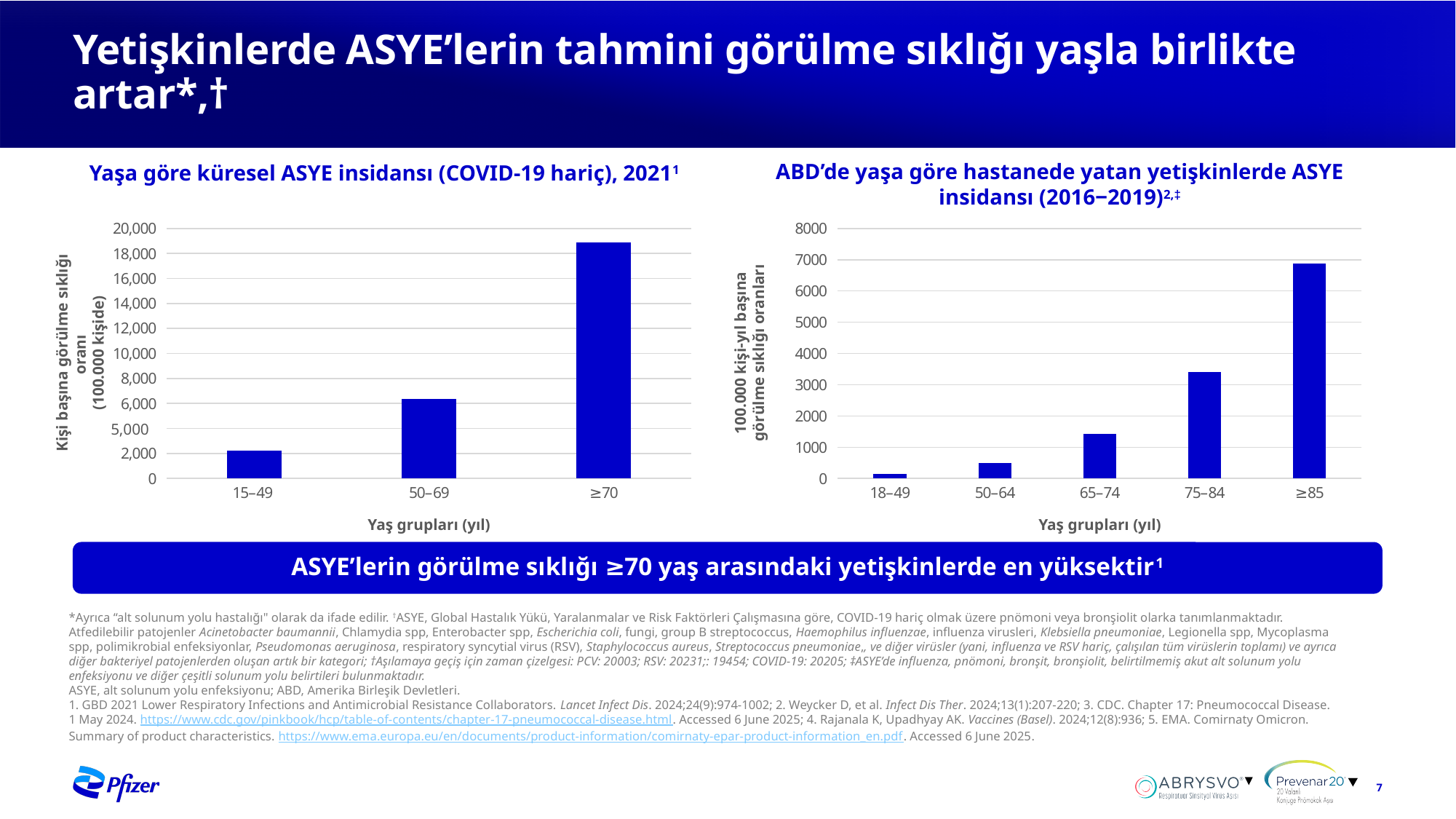
On the left chart (Yaşa göre küresel ASYE insidansı), which age group has the lowest incidence? 15–49 On the left chart (Yaşa göre küresel ASYE insidansı), which age group has the highest incidence? ≥70 On the left chart (Yaşa göre küresel ASYE insidansı), do the values rise or fall as age increases along the x axis? rise What type of chart is the left chart (Yaşa göre küresel ASYE insidansı)? bar chart On the left chart (Yaşa göre küresel ASYE insidansı), how many age groups are shown? 3 On the right chart (ABD'de yaşa göre hastanede yatan yetişkinlerde ASYE insidansı), which is larger, the value for 65–74 or the value for 50–64? 65–74 On the right chart (ABD'de yaşa göre hastanede yatan yetişkinlerde ASYE insidansı), which age group has the highest incidence? ≥85 On the right chart (ABD'de yaşa göre hastanede yatan yetişkinlerde ASYE insidansı), how many age groups are shown? 5 On the right chart (ABD'de yaşa göre hastanede yatan yetişkinlerde ASYE insidansı), which age group has the lowest incidence? 18–49 On the right chart (ABD'de yaşa göre hastanede yatan yetişkinlerde ASYE insidansı), is the value for 75–84 greater or less than 3000? greater On the left chart (Yaşa göre küresel ASYE insidansı), is the value for ≥70 greater or less than 18,000? greater On the left chart (Yaşa göre küresel ASYE insidansı), is the value for 15–49 greater or less than 5,000? less